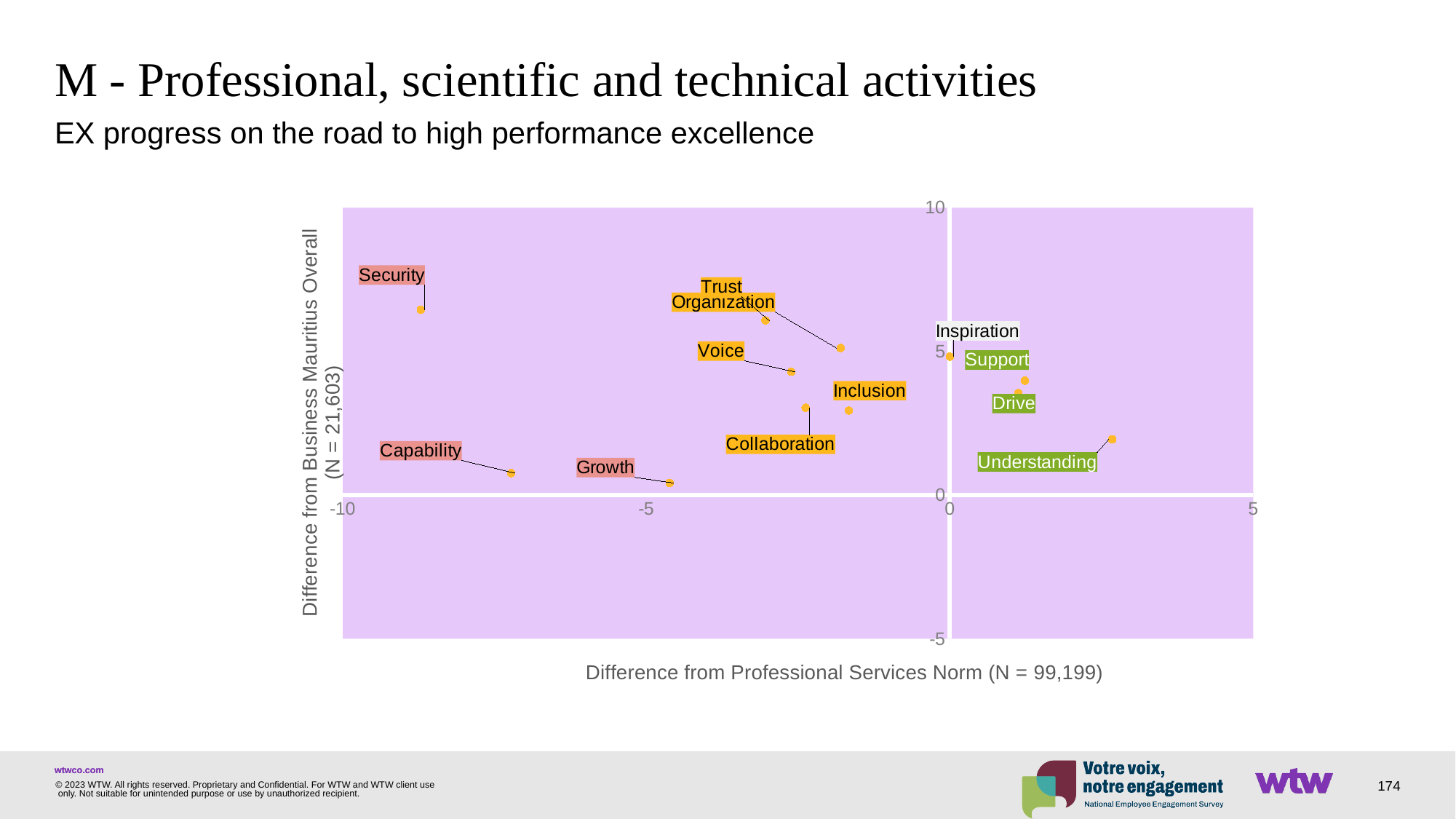
Is the vertical-axis value for Growth greater or less than 5? less Is the horizontal-axis value for Understanding greater or less than 0? greater What is the label of the horizontal axis? Difference from Professional Services Norm (N = 99,199) Which labelled point is furthest to the right on the horizontal axis (Difference from Professional Services Norm)? Understanding What kind of chart is shown on the slide? Scatter chart How many labelled data points are plotted on the chart? 12 Is the vertical-axis value for Security greater or less than 5? greater Which labelled point is furthest to the left on the horizontal axis (Difference from Professional Services Norm)? Security Which has the higher vertical-axis value, Security or Growth? Security Which labelled point is highest on the vertical axis (Difference from Business Mauritius Overall)? Security Which has the higher horizontal-axis value, Understanding or Capability? Understanding